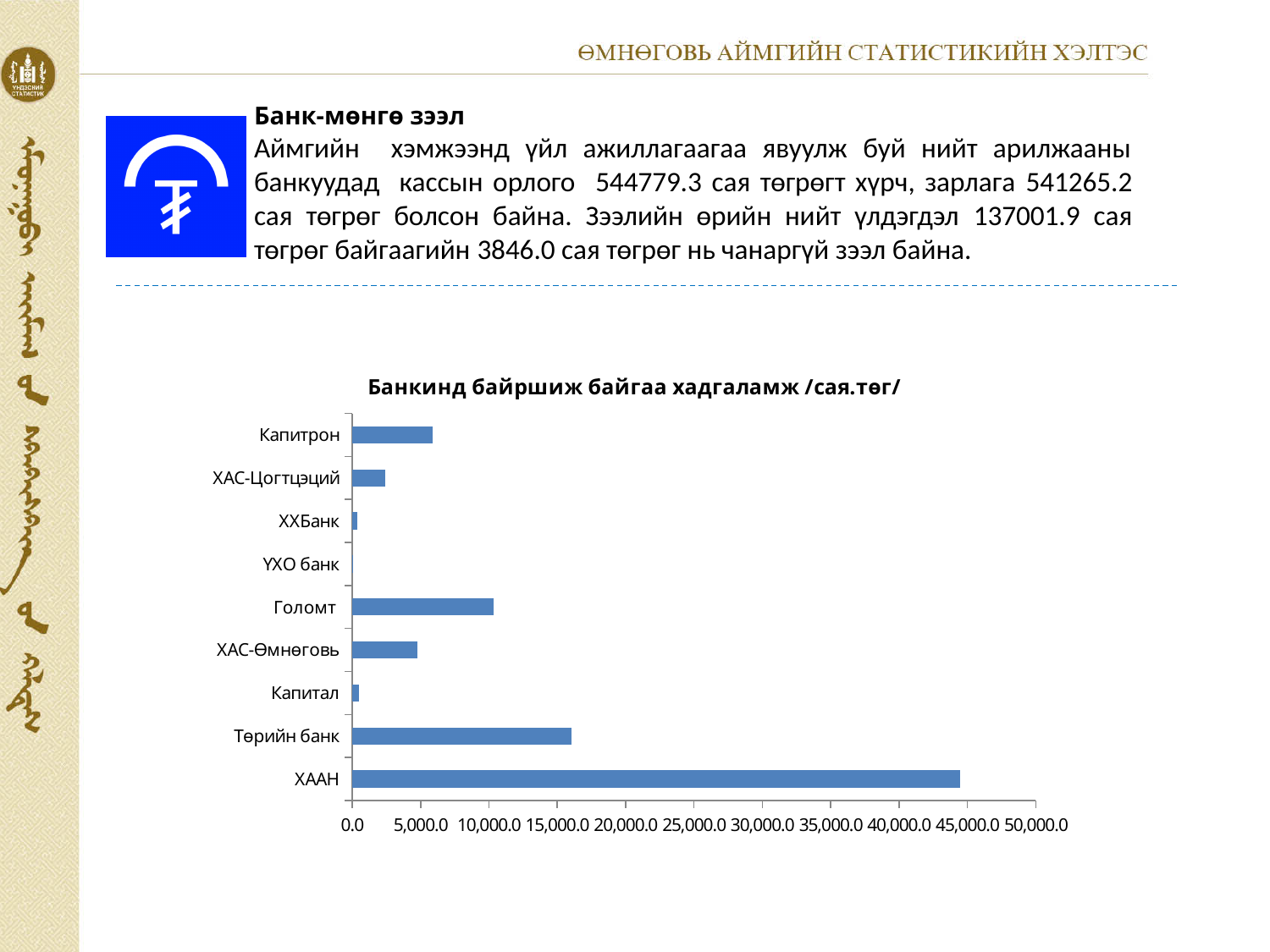
How many banks (categories) are shown in the chart? 9 What kind of chart is shown on the slide? bar chart What is the title of the chart? Банкинд байршиж байгаа хадгаламж /сая.төг/ Is the value for Төрийн банк greater or less than 15,000.0? greater What colour are the bars in the chart? blue Is the value for Голомт greater or less than 5,000.0? greater Which bank has the highest value in the chart? ХААН Which bank has the lowest value in the chart? ҮХО банк Is the value for ХААН greater or less than 40,000.0? greater Which has a larger value, Төрийн банк or Голомт? Төрийн банк Which has a larger value, Голомт or Капитрон? Голомт